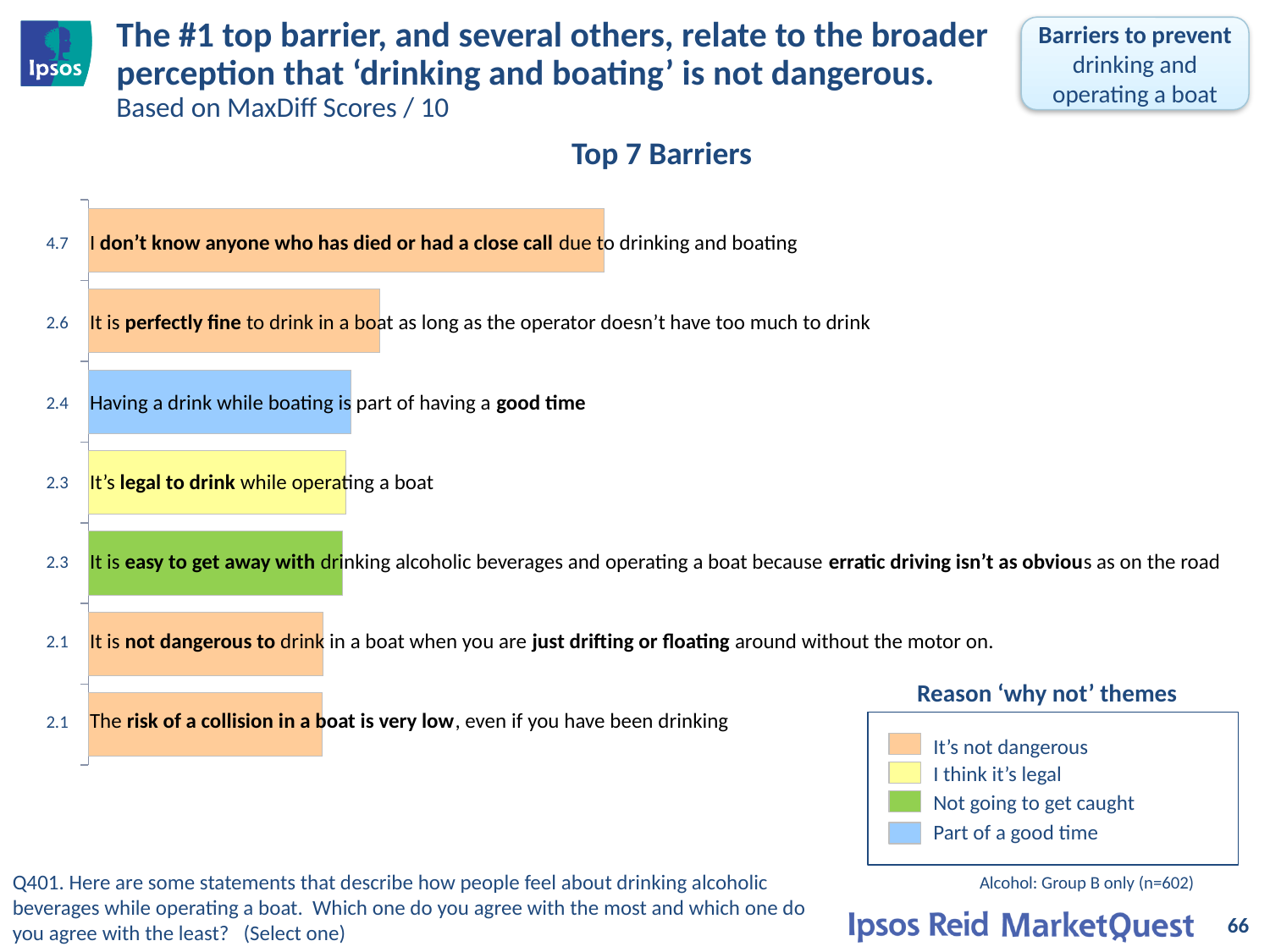
What is the difference between the highest score (4.7) and the second-highest score (2.6)? 2.1 What type of chart is used to show the Top 7 Barriers? Bar chart What is the score for 'Having a drink while boating is part of having a good time'? 2.4 How many 'why not' themes does the legend list? 4 Which has a higher score: 'Having a drink while boating is part of having a good time' or 'It is perfectly fine to drink in a boat as long as the operator doesn't have too much to drink'? It is perfectly fine to drink in a boat as long as the operator doesn't have too much to drink What is the MaxDiff score for the barrier 'I don't know anyone who has died or had a close call due to drinking and boating'? 4.7 What is the score for 'The risk of a collision in a boat is very low, even if you have been drinking'? 2.1 What is the score for 'It is perfectly fine to drink in a boat as long as the operator doesn't have too much to drink'? 2.6 How many barriers are shown in the Top 7 Barriers chart? 7 Which barrier has the highest score in the Top 7 Barriers chart? I don't know anyone who has died or had a close call due to drinking and boating Which 'why not' theme does the green bar represent? Not going to get caught What is the score for 'It's legal to drink while operating a boat'? 2.3